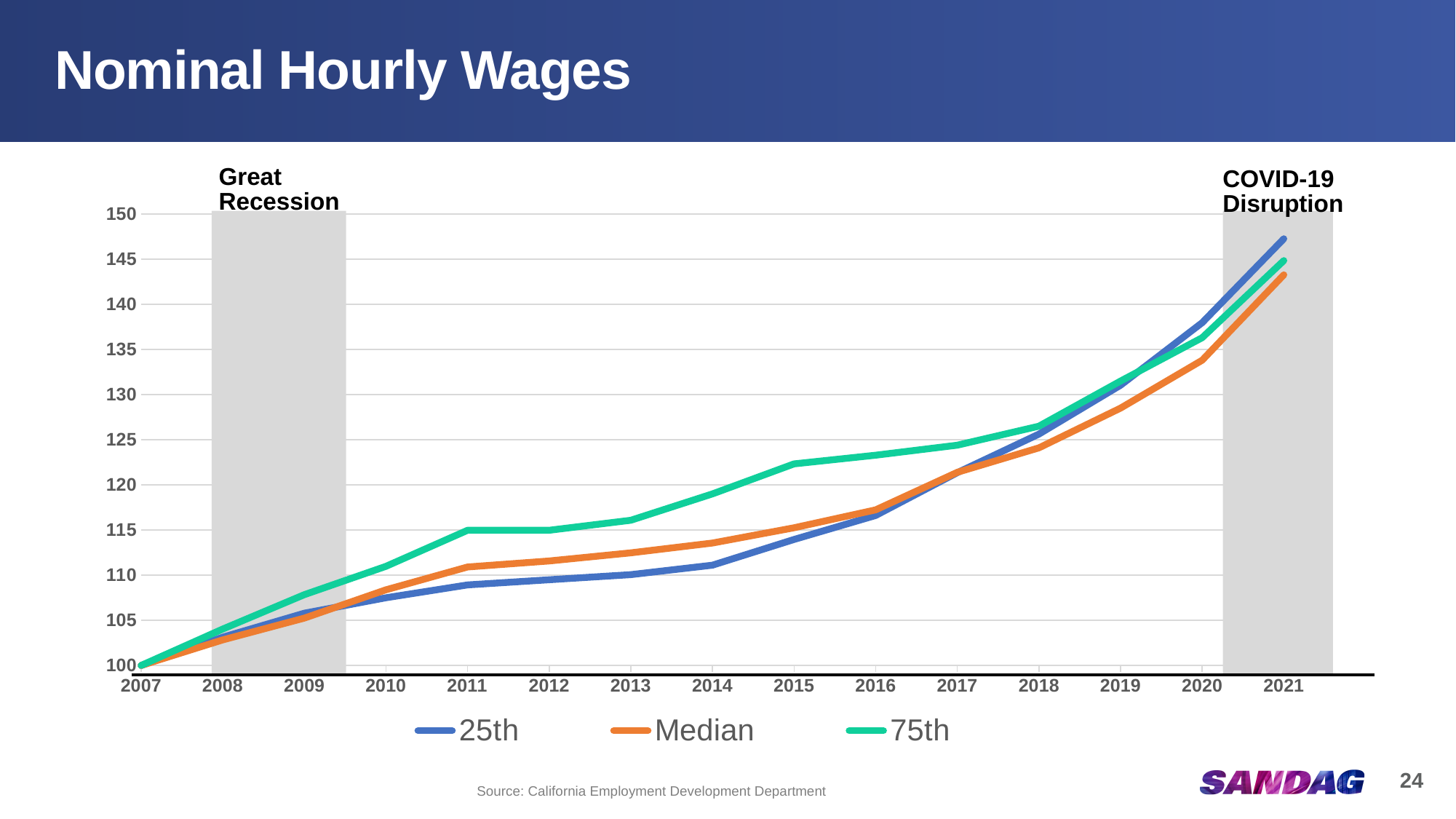
What kind of chart is shown on the slide? line chart Is the value for the Median series in 2018 greater or less than 125? less In 2015, which is larger: the 75th series or the 25th series? 75th Do the values of the 25th series rise or fall from 2007 to 2021? rise Is the value for the 25th series in 2021 greater or less than 145? greater Which series has the highest value in 2021? 25th How many years are plotted along the x axis? 15 How many series does the legend list? 3 Is the value for the 75th series in 2015 greater or less than 120? greater What is the value of the Median series in 2007? 100 What is the title of the chart? Nominal Hourly Wages Which series has the lowest value in 2014? 25th